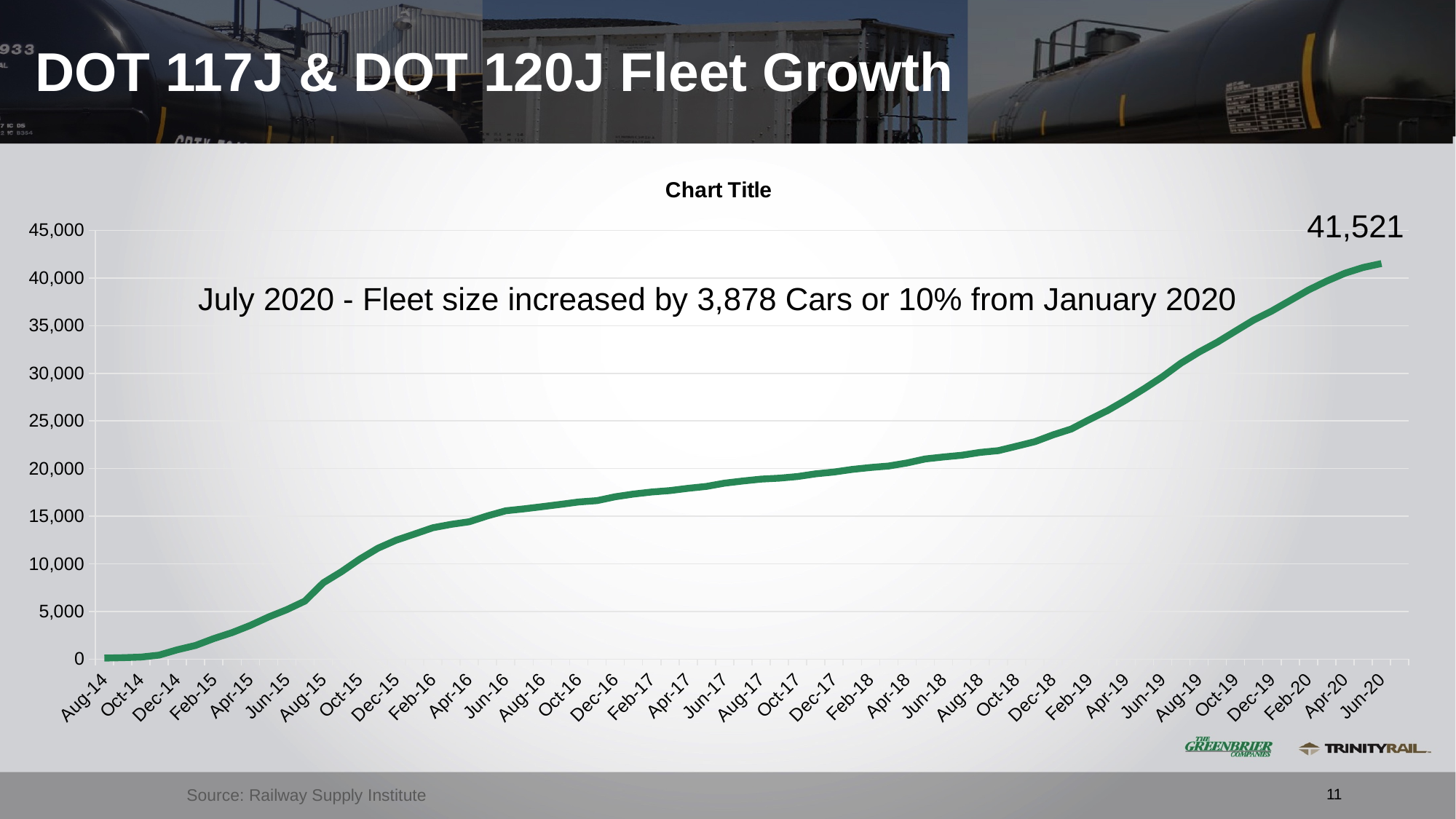
What kind of chart is shown on the slide? line chart What is the title printed above the chart? Chart Title Is the value for Apr-17 greater or less than 20,000? less At which x-axis label is the line at its lowest value? Aug-14 Is the value for Dec-15 greater or less than 10,000? greater What is the value printed at the end of the line (Jun-20)? 41,521 According to the annotation on the chart, by how many cars did the fleet size increase from January 2020 to July 2020? 3,878 Cars Which is larger, the value for Oct-18 or the value for Jun-16? Oct-18 Is the value for Aug-19 greater or less than 30,000? greater At which x-axis label does the line reach its highest value? Jun-20 Do the values rise or fall along the x axis from Aug-14 to Jun-20? rise